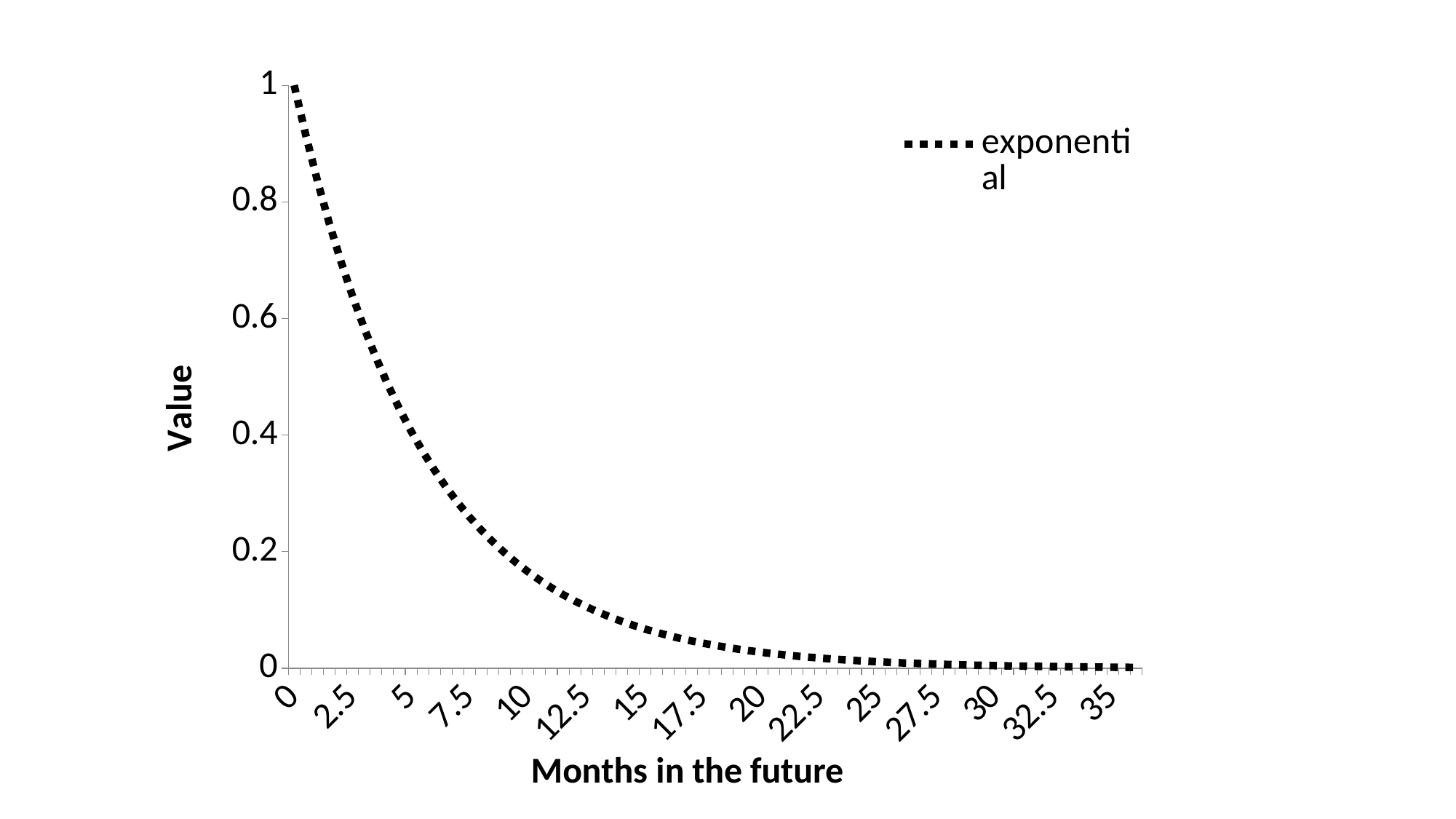
What is the title of the x axis? Months in the future Is the value of the exponential series at 15 months greater or less than 0.2? less Is the value of the exponential series at 20 months greater or less than 0.2? less Which is larger, the value of the exponential series at 5 months or at 25 months? 5 months What is the name of the series shown in the legend? exponential What kind of chart is shown on the slide? line chart What is the value of the exponential series at 0 months in the future? 1 How many series does the legend list? 1 Is the value of the exponential series at 2.5 months greater or less than 0.6? greater At which month shown on the x axis is the exponential series at its highest value? 0 Do the values of the exponential series rise or fall as months in the future increase? fall